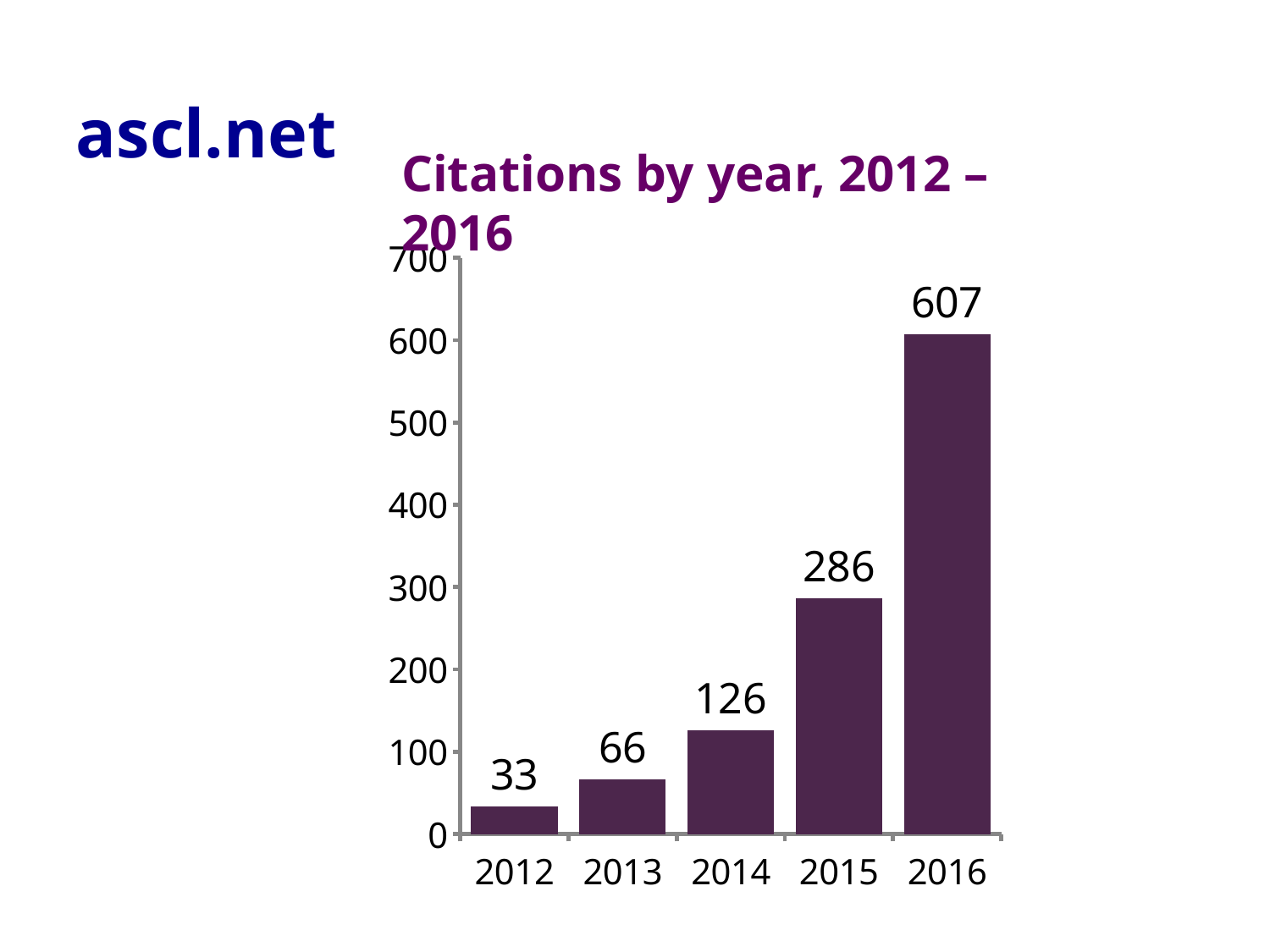
Is the value for 2015 greater or less than 200? greater What is the number of citations for 2013? 66 What is the number of citations for 2016? 607 How many years are shown on the x axis? 5 What is the number of citations for 2014? 126 What is the difference in citations between 2014 and 2013? 60 What kind of chart is shown on the slide? Bar chart Which year has the lowest number of citations? 2012 Do the citation counts rise or fall from 2012 to 2016? Rise Which year has more citations, 2015 or 2014? 2015 Which year has the highest number of citations? 2016 What is the difference in citations between 2016 and 2015? 321